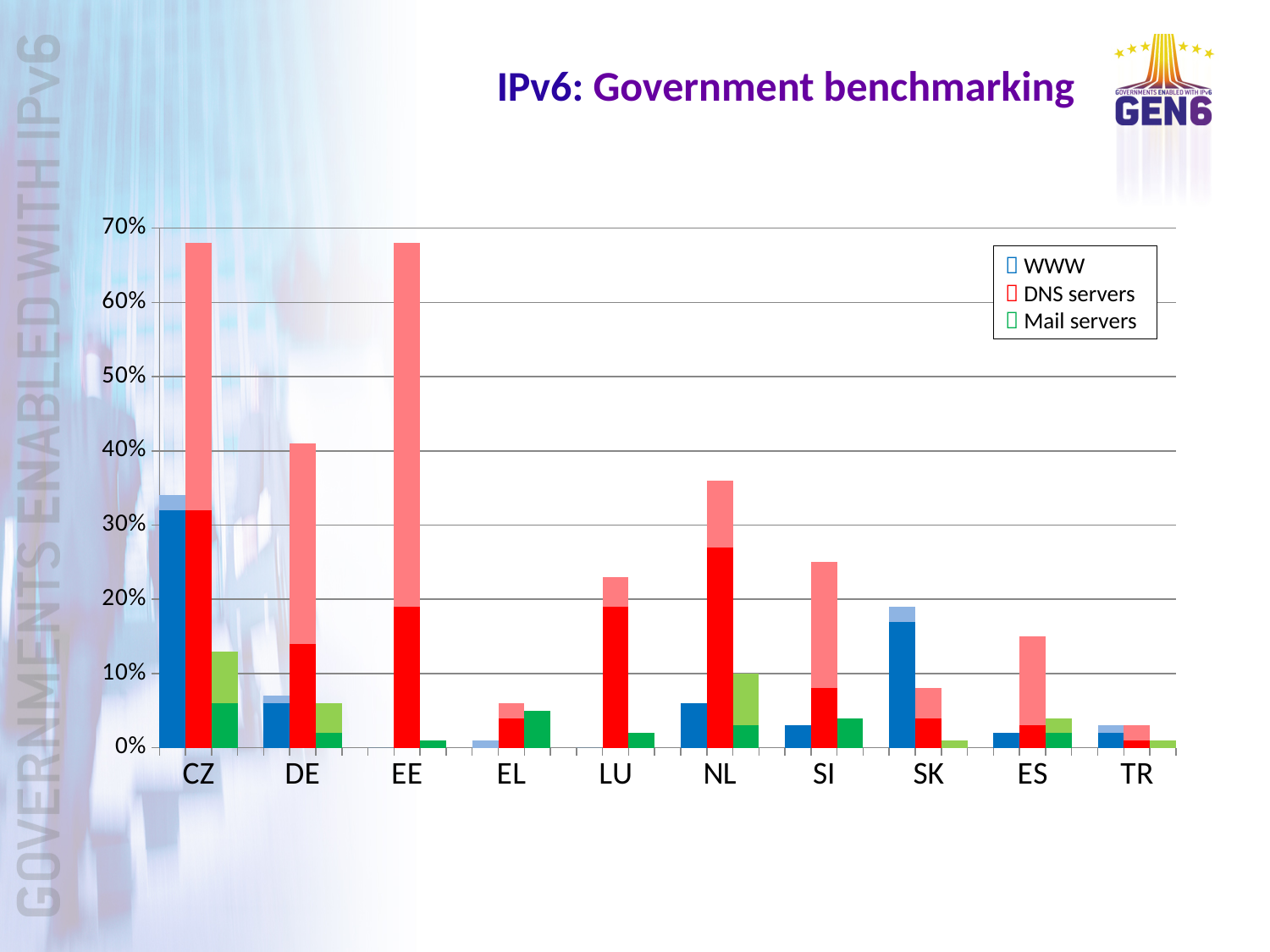
How many series does the legend list? 3 How many countries are shown on the x axis? 10 Is the Mail servers value for NL greater or less than 20%? less What kind of chart is shown on the slide? bar chart What is the title of the chart? IPv6: Government benchmarking Which is larger, the WWW value for SK or the WWW value for DE? SK Which country has the highest Mail servers value? CZ Is the DNS servers value for NL greater or less than 20%? greater What are the three series named in the legend? WWW, DNS servers, Mail servers Is the WWW value for CZ greater or less than 30%? greater Which country has the highest WWW value? CZ